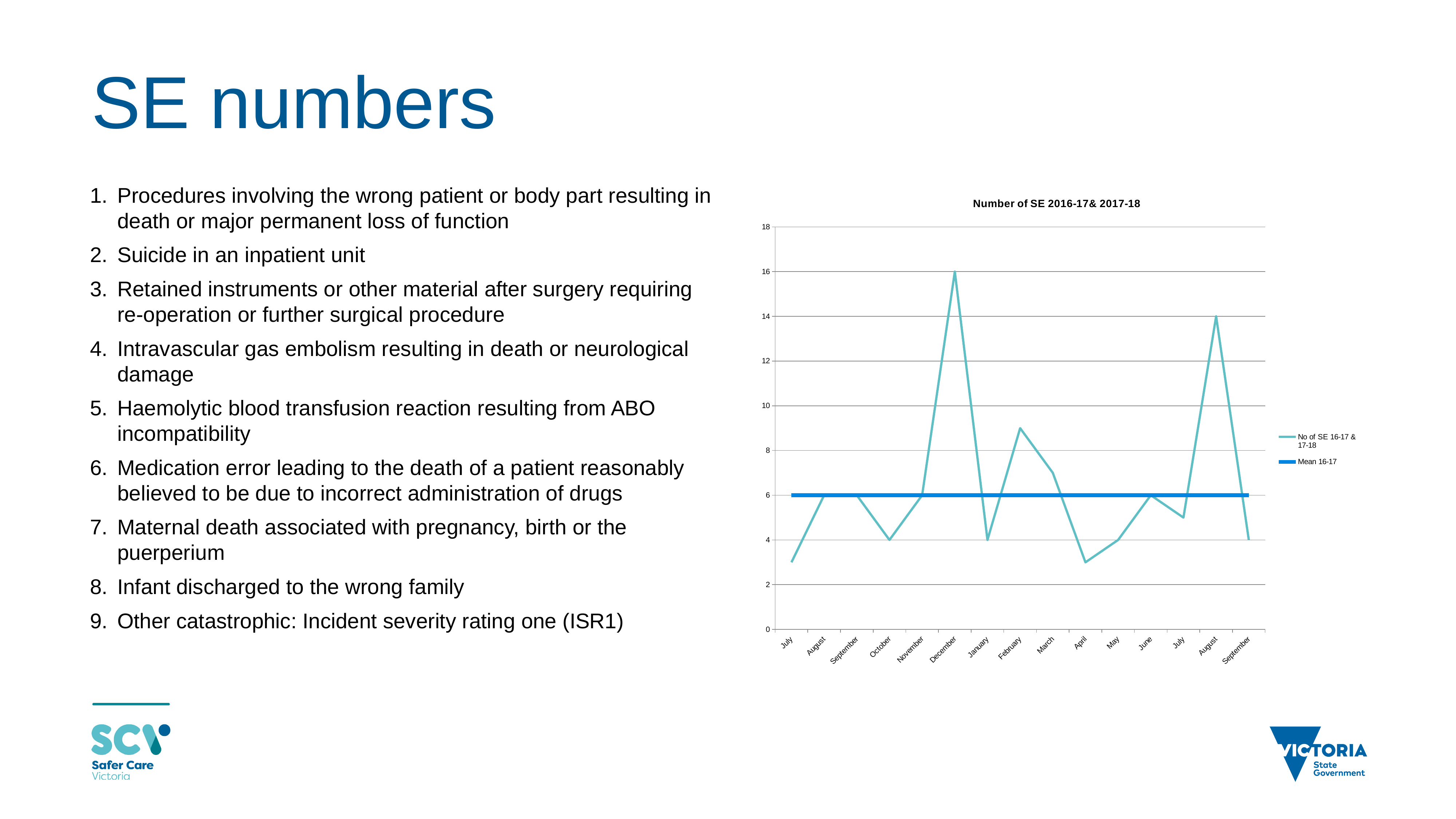
How many series does the chart legend list? 2 What is the number of SE in December? 16 What is the difference between the number of SE in December and in the second August? 2 How many months are plotted along the x axis of the chart? 15 What kind of chart is shown on the slide? line chart What is the number of SE in October? 4 What is the number of SE in the second August shown on the x axis? 14 What value does the Mean 16-17 line sit at? 6 Is the number of SE in February greater or less than 8? greater In which month does the number of SE reach its highest value? December What is the title of the chart? Number of SE 2016-17& 2017-18 Is the number of SE in April greater or less than 4? less